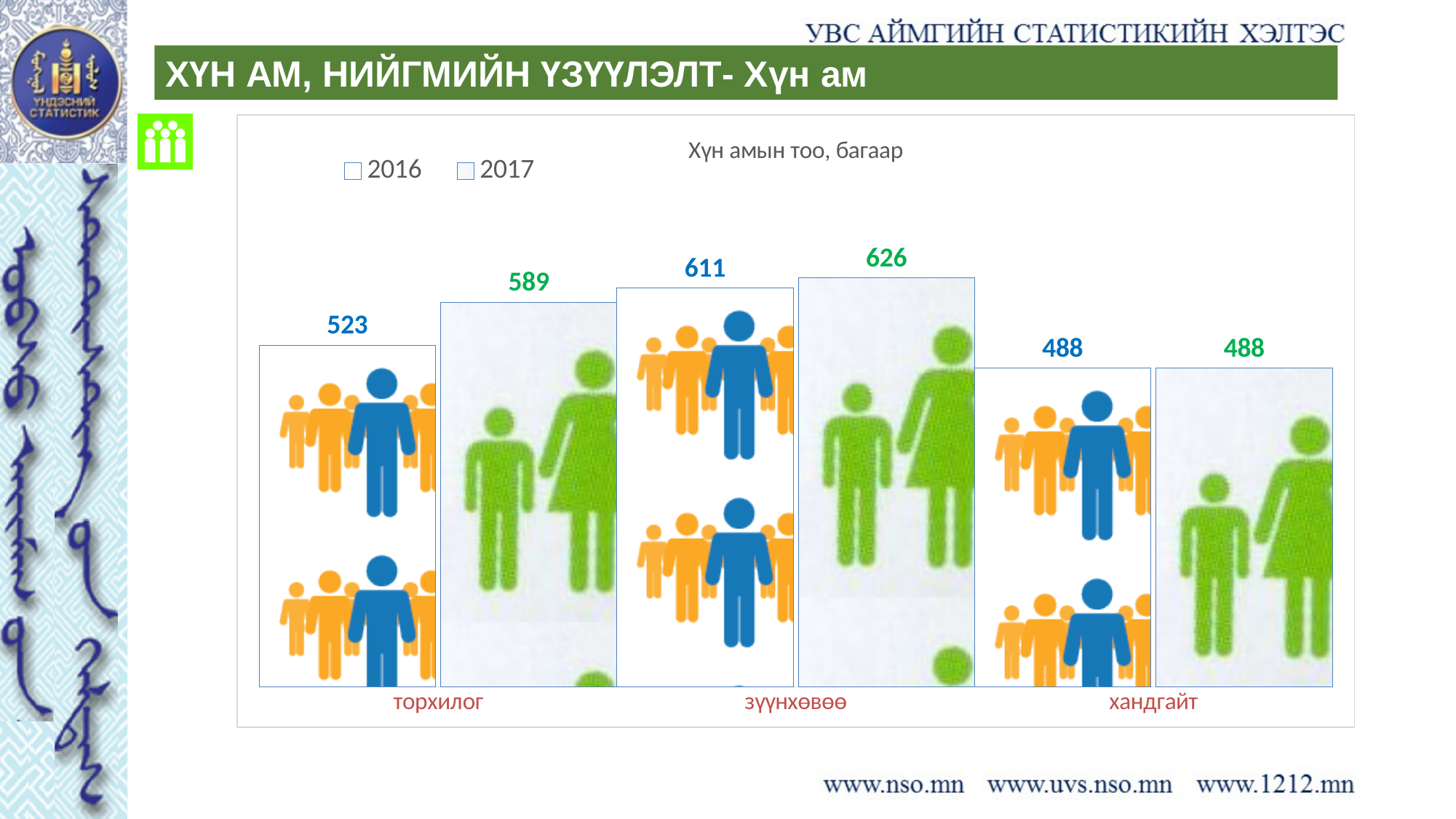
How many series does the legend list? 2 What type of chart is shown on the slide? bar chart How many categories are shown on the x axis? 3 What is the 2017 value for хандгайт? 488 What is the difference between the 2017 and 2016 values for торхилог? 66 What is the 2017 value for зүүнхөвөө? 626 What is the 2016 value for торхилог? 523 What is the title of the chart? Хүн амын тоо, багаар Which category has the highest 2017 value? зүүнхөвөө Which is larger for зүүнхөвөө, the 2016 value or the 2017 value? 2017 Which category has the lowest 2016 value? хандгайт What is the difference between the 2017 values for зүүнхөвөө and хандгайт? 138